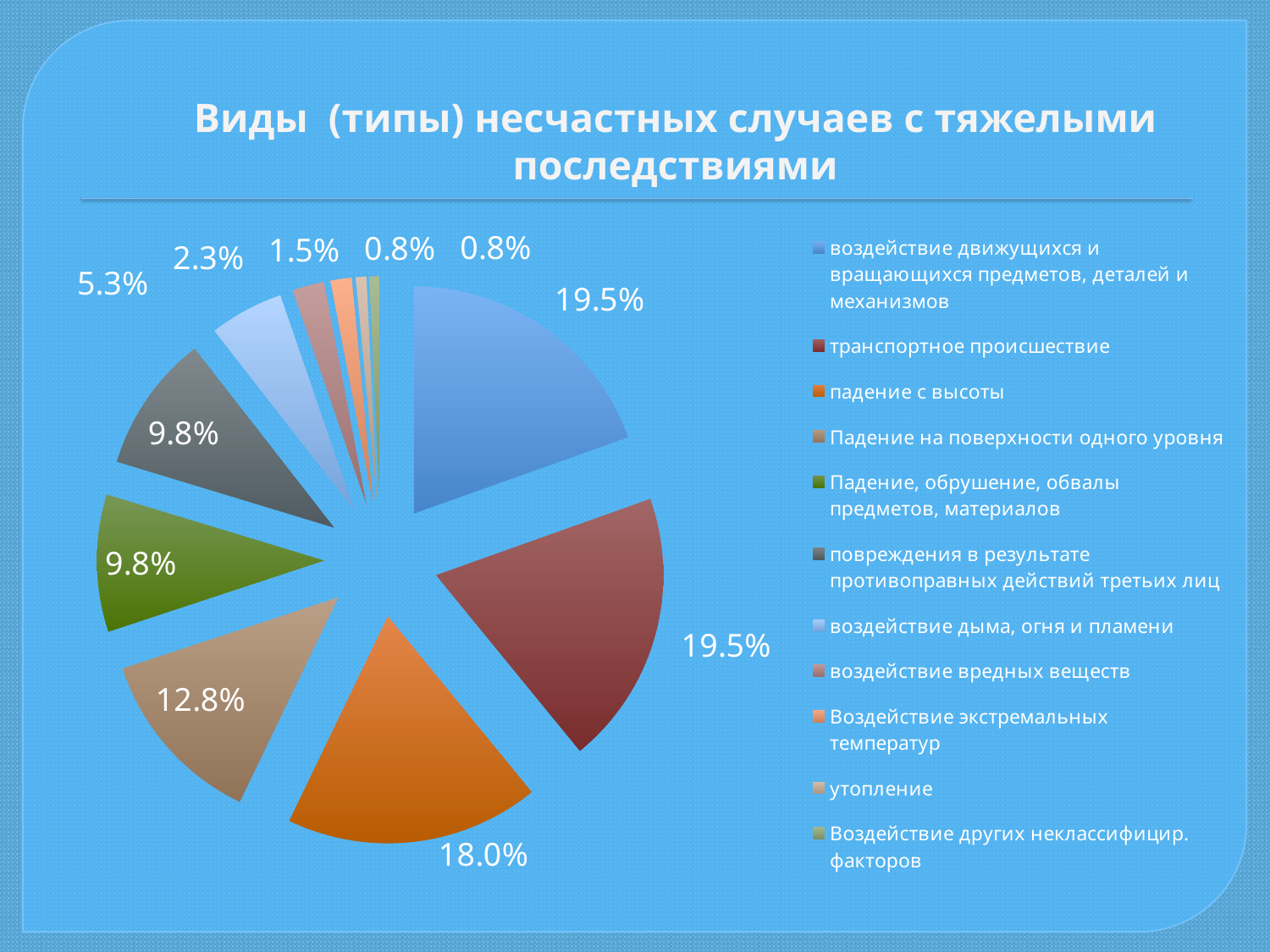
What is the share for "воздействие дыма, огня и пламени"? 5.3% What is the share for "транспортное происшествие"? 19.5% Which is larger: the share for "падение с высоты" or the share for "Падение на поверхности одного уровня"? падение с высоты What is the share for "утопление"? 0.8% What is the share for "Падение на поверхности одного уровня"? 12.8% What is the difference between the share for "транспортное происшествие" and the share for "воздействие дыма, огня и пламени"? 14.2% How many entries does the legend list? 11 What type of chart is shown on the slide? pie chart What is the share for "Воздействие экстремальных температур"? 1.5% What is the share for "воздействие вредных веществ"? 2.3% What is the title of the chart? Виды (типы) несчастных случаев с тяжелыми последствиями What is the share for "падение с высоты"? 18.0%